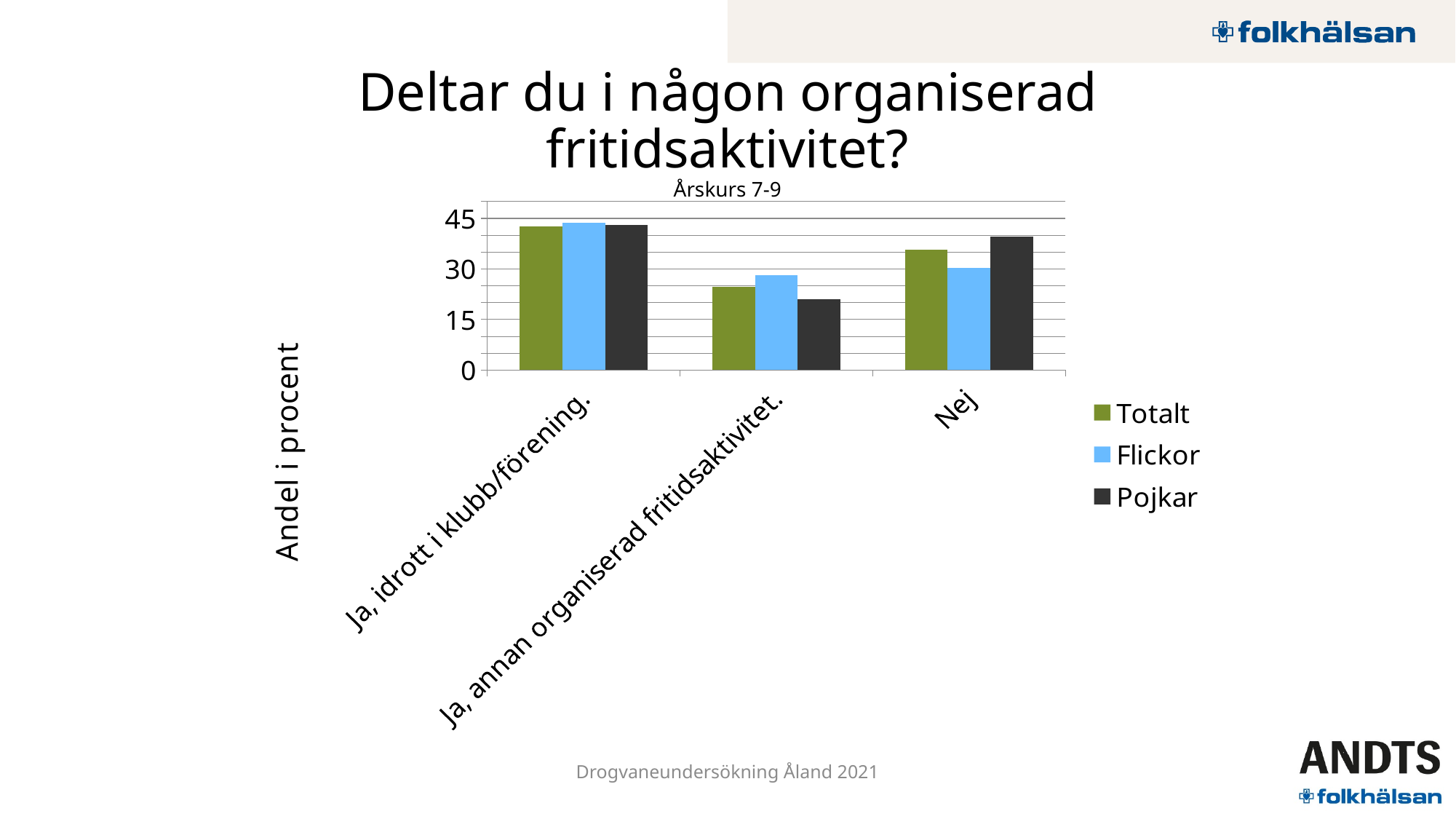
What is the subtitle shown directly above the chart? Årskurs 7-9 For Pojkar, which is larger: the value for "Nej" or the value for "Ja, annan organiserad fritidsaktivitet."? Nej How many series does the legend list? 3 Which series has the highest value in the category "Ja, annan organiserad fritidsaktivitet."? Flickor Is the value for Pojkar in the category "Ja, annan organiserad fritidsaktivitet." greater or less than 30? less Is the value for Pojkar in the category "Nej" greater or less than 30? greater What is the label on the vertical axis? Andel i procent Which series has the lowest value in the category "Nej"? Flickor How many answer categories are shown on the x axis? 3 Is the value for Totalt in the category "Ja, annan organiserad fritidsaktivitet." greater or less than 30? less What kind of chart is shown on the slide? bar chart